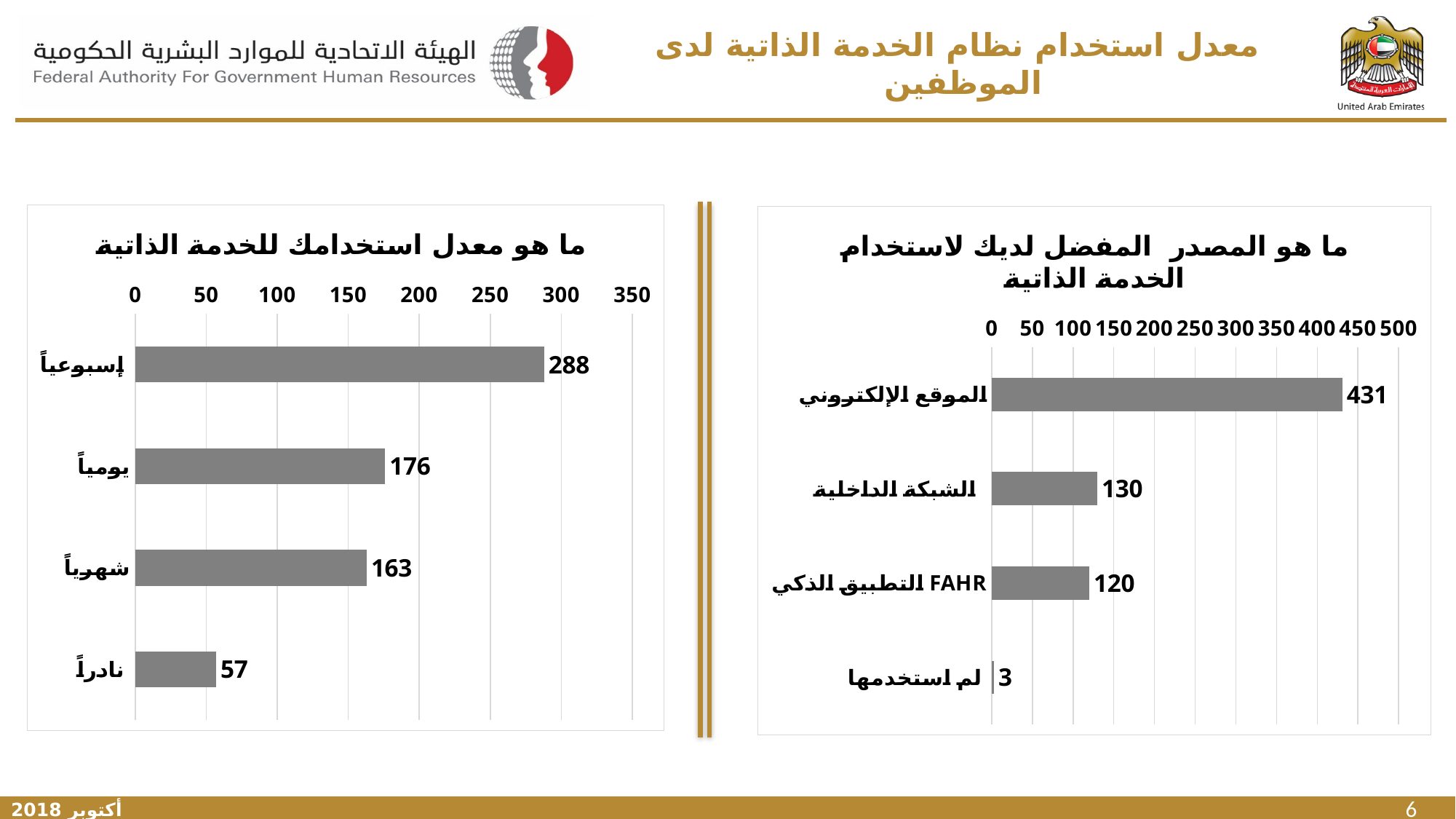
In the right chart (ما هو المصدر المفضل لديك لاستخدام الخدمة الذاتية), which category has the lowest value? لم استخدمها In the right chart (ما هو المصدر المفضل لديك لاستخدام الخدمة الذاتية), which is larger: الشبكة الداخلية or التطبيق الذكي FAHR? الشبكة الداخلية In the left chart (ما هو معدل استخدامك للخدمة الذاتية), how many categories are shown? 4 In the right chart (ما هو المصدر المفضل لديك لاستخدام الخدمة الذاتية), what is the value for لم استخدمها? 3 In the left chart (ما هو معدل استخدامك للخدمة الذاتية), what is the value for إسبوعياً? 288 In the right chart (ما هو المصدر المفضل لديك لاستخدام الخدمة الذاتية), what is the difference between الموقع الإلكتروني and الشبكة الداخلية? 301 In the left chart (ما هو معدل استخدامك للخدمة الذاتية), what is the value for نادراً? 57 In the left chart (ما هو معدل استخدامك للخدمة الذاتية), what is the difference between يومياً and شهرياً? 13 What type of chart is the right chart (ما هو المصدر المفضل لديك لاستخدام الخدمة الذاتية)? Bar chart In the right chart (ما هو المصدر المفضل لديك لاستخدام الخدمة الذاتية), what is the value for الموقع الإلكتروني? 431 In the left chart (ما هو معدل استخدامك للخدمة الذاتية), what is the highest value shown on the axis? 350 In the left chart (ما هو معدل استخدامك للخدمة الذاتية), which category has the highest value? إسبوعياً